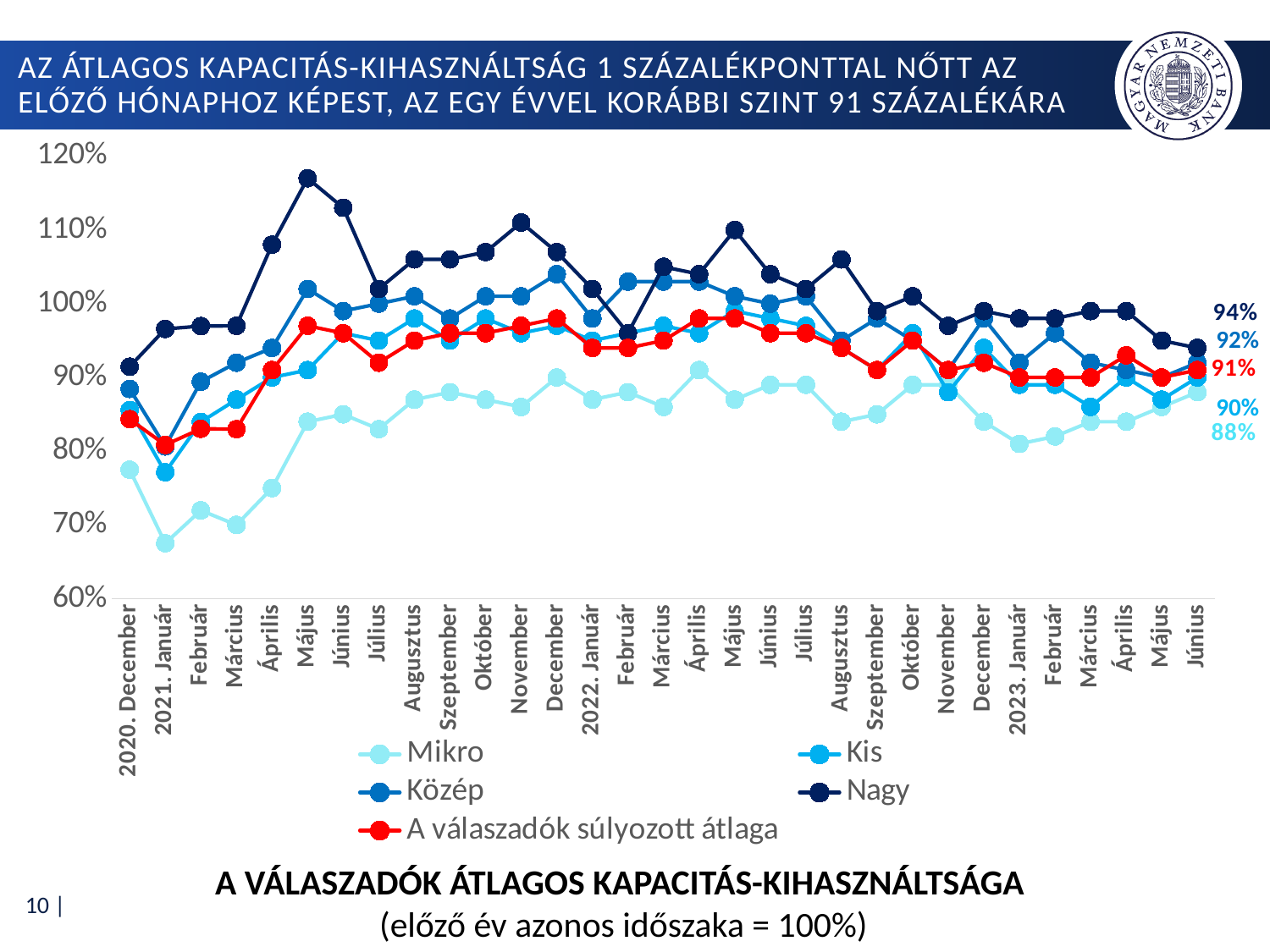
Is the value for Nagy in 2021 Május greater or less than 110%? greater Is the value for Mikro in 2021 Január greater or less than 70%? less What is the value for Közép in 2023 Június? 92% How many series does the legend list? 5 Which series has the highest value in 2023 Június? Nagy What kind of chart is shown on the slide? line chart What is the value for Nagy in 2023 Június? 94% Which series has the lowest value in 2021 Január? Mikro What is the difference between the Nagy and Mikro values in 2023 Június? 6 percentage points How many months are shown on the x axis? 31 What is the value for Mikro in 2023 Június? 88% What is the value for A válaszadók súlyozott átlaga in 2023 Június? 91%